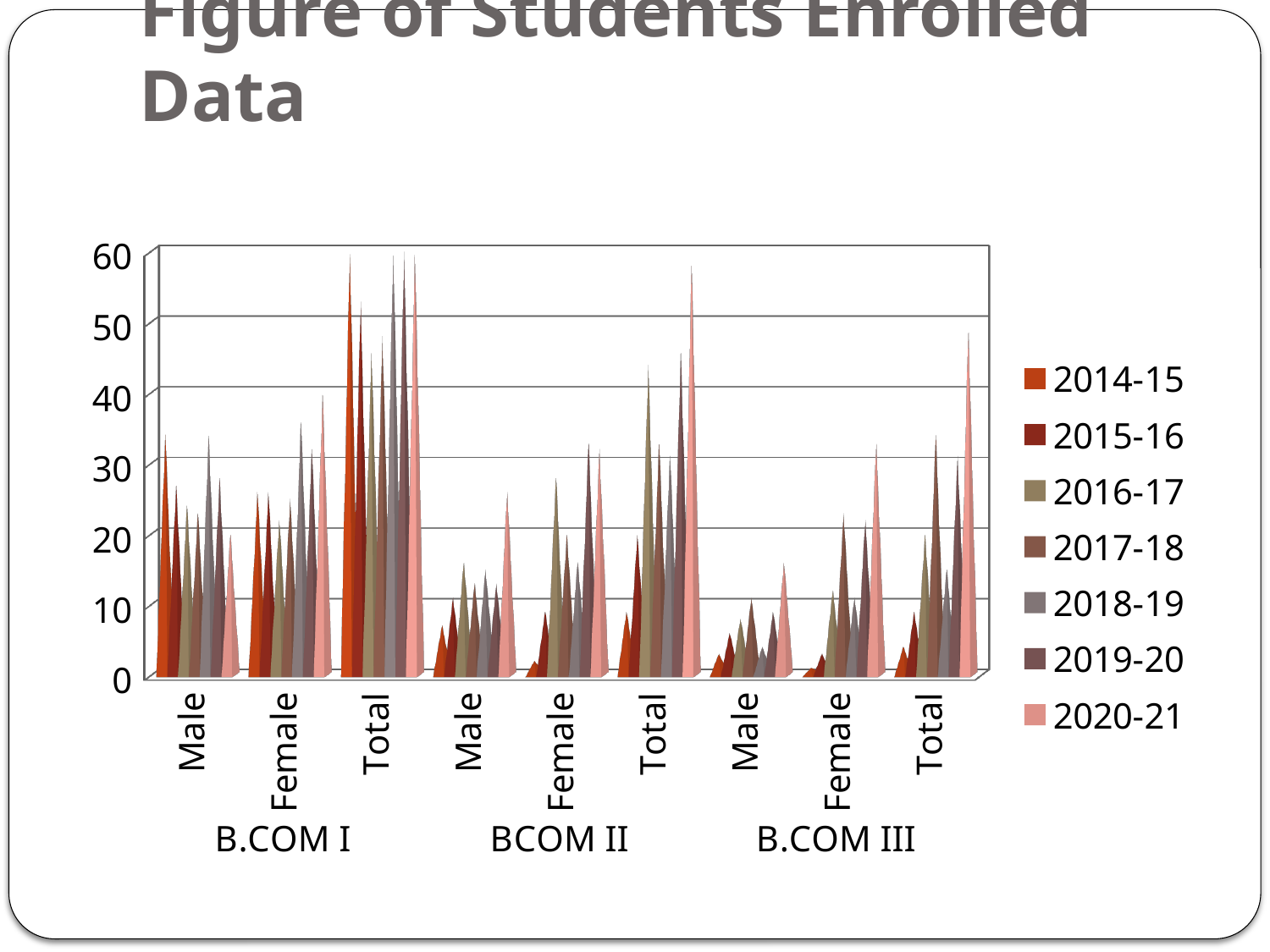
Is the value for BCOM II Total in 2020-21 greater or less than 50? greater Is the value for B.COM III Total in 2020-21 greater or less than 40? greater How many series does the legend list? 7 For B.COM III Total, which series has the highest value? 2020-21 What kind of chart is shown on the slide? bar chart How many categories are shown along the x axis? 9 Which is larger: the 2014-15 value for B.COM I Total or the 2014-15 value for B.COM III Total? B.COM I Total Which series is listed first in the legend? 2014-15 Is the value for B.COM I Total in 2014-15 greater or less than 50? greater For B.COM III Total, which series has the lowest value? 2014-15 Which series is listed last in the legend? 2020-21